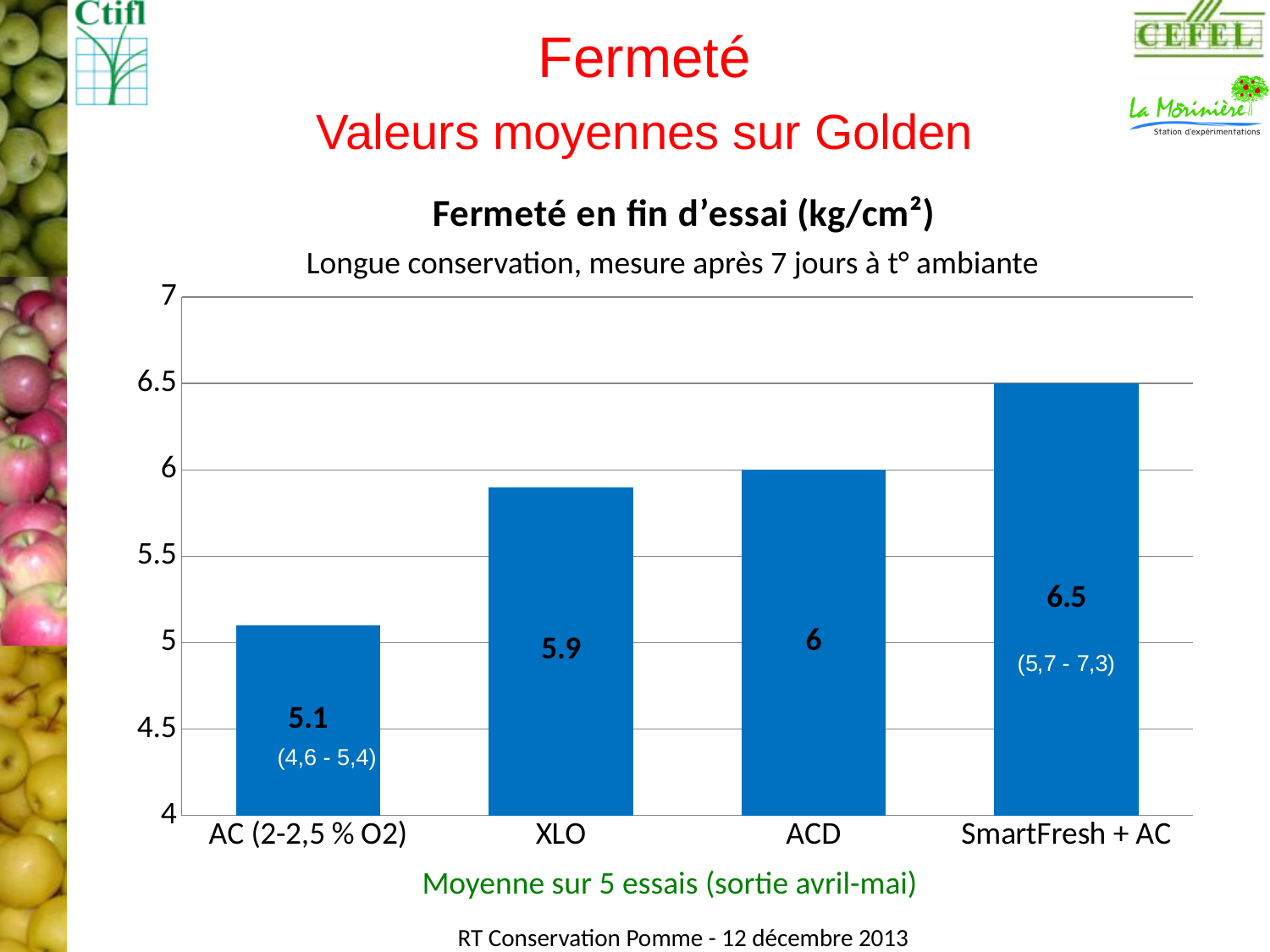
What is the firmness value for SmartFresh + AC? 6.5 Which category has the lowest firmness value? AC (2-2,5 % O2) What is the firmness value for XLO? 5.9 What kind of chart is shown on the slide? bar chart What is the firmness value for ACD? 6 What range is shown in parentheses for SmartFresh + AC? (5,7 - 7,3) Which category has the highest firmness value? SmartFresh + AC What is the difference between the firmness values for SmartFresh + AC and AC (2-2,5 % O2)? 1.4 What is the firmness value for AC (2-2,5 % O2)? 5.1 Is the value for XLO greater or less than 6? less How many categories are shown on the x axis? 4 Which has a higher firmness value, XLO or ACD? ACD